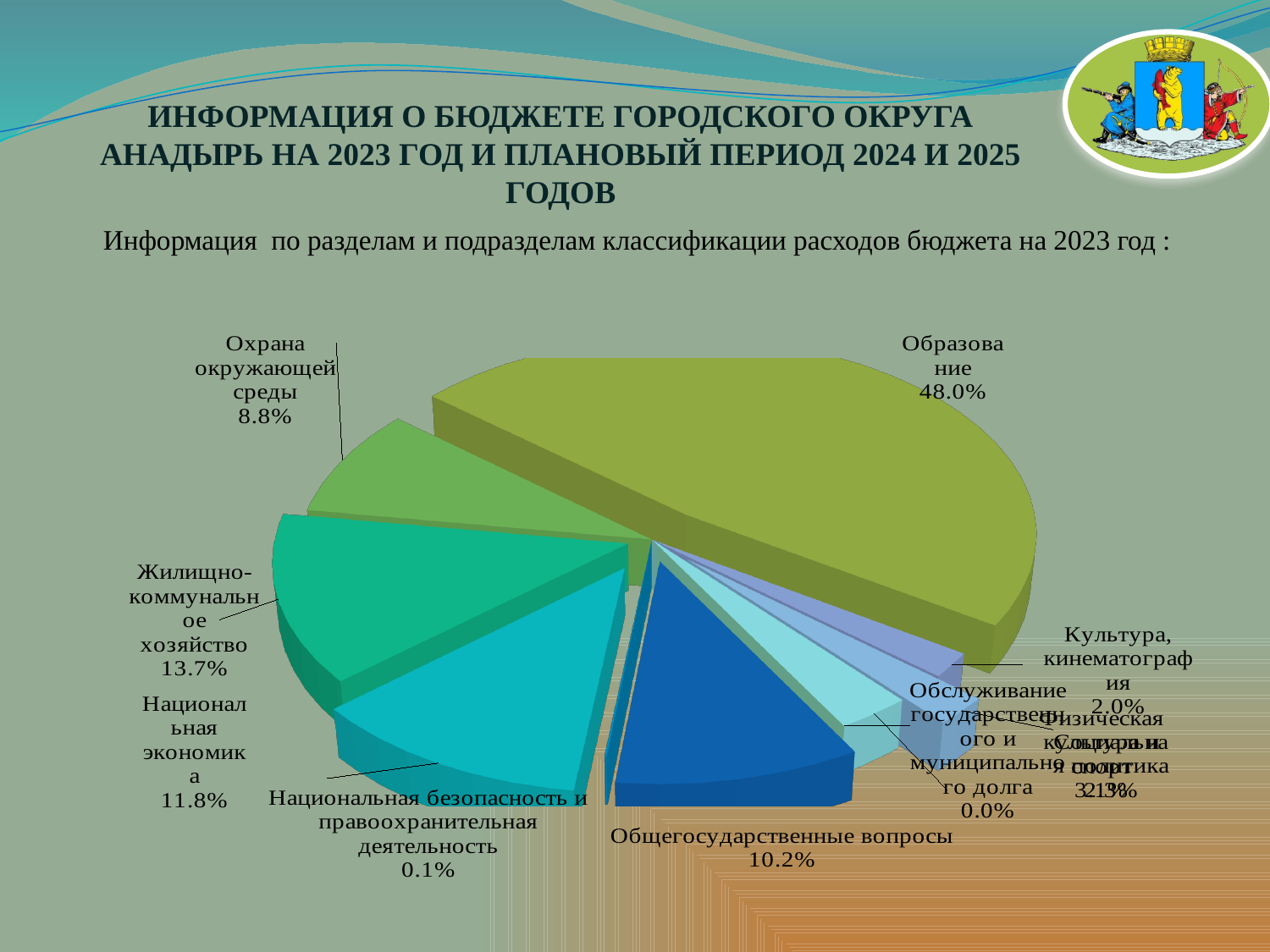
What percentage is shown for Обслуживание государственного и муниципального долга? 0.0% What percentage is shown for Общегосударственные вопросы? 10.2% Which is larger: the share for Жилищно-коммунальное хозяйство or for Национальная экономика? Жилищно-коммунальное хозяйство What share of the budget expenditures does Образование account for? 48.0% By how many percentage points does Образование exceed Жилищно-коммунальное хозяйство? 34.3 What percentage is shown for Охрана окружающей среды? 8.8% Which section has the largest share of the pie? Образование What percentage is shown for Культура, кинематография? 2.0% What percentage is shown for Национальная безопасность и правоохранительная деятельность? 0.1% What percentage is shown for Национальная экономика? 11.8% What kind of chart is shown on the slide? pie chart What percentage is shown for Жилищно-коммунальное хозяйство? 13.7%